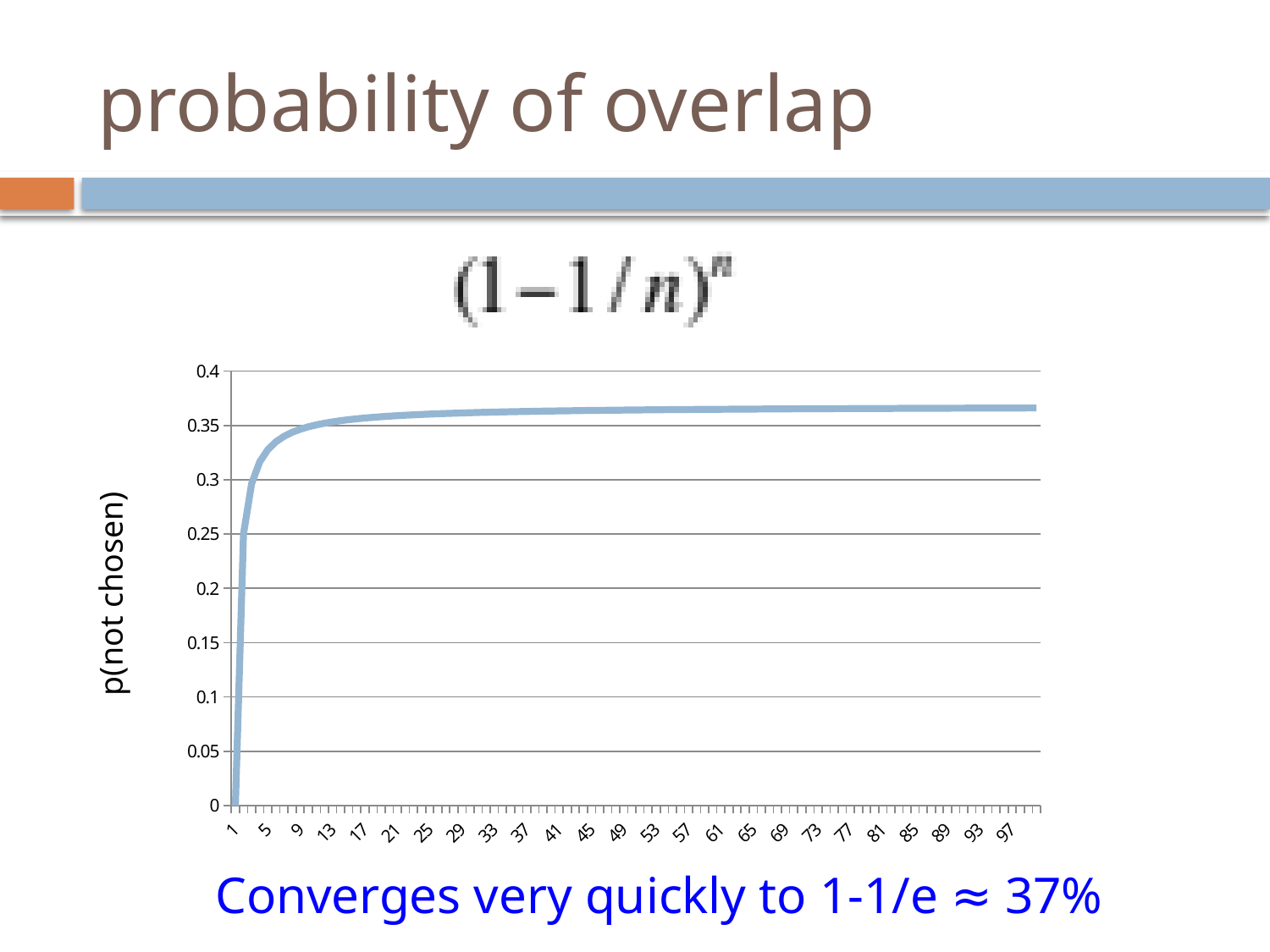
Is the value of p(not chosen) at n = 5 greater or less than 0.3? greater Does p(not chosen) rise or fall as n increases along the x axis? rises What is the last label shown on the x axis of the chart? 97 What is the label on the y axis of the chart? p(not chosen) At which value of n is p(not chosen) lowest? 1 Is the value of p(not chosen) at n = 49 greater or less than 0.35? greater Is the value of p(not chosen) at n = 97 greater or less than 0.35? greater What is the highest value shown on the y axis of the chart? 0.4 Which is larger, p(not chosen) at n = 1 or at n = 97? n = 97 What kind of chart is shown on the slide? line chart What is the value of p(not chosen) at n = 1? 0